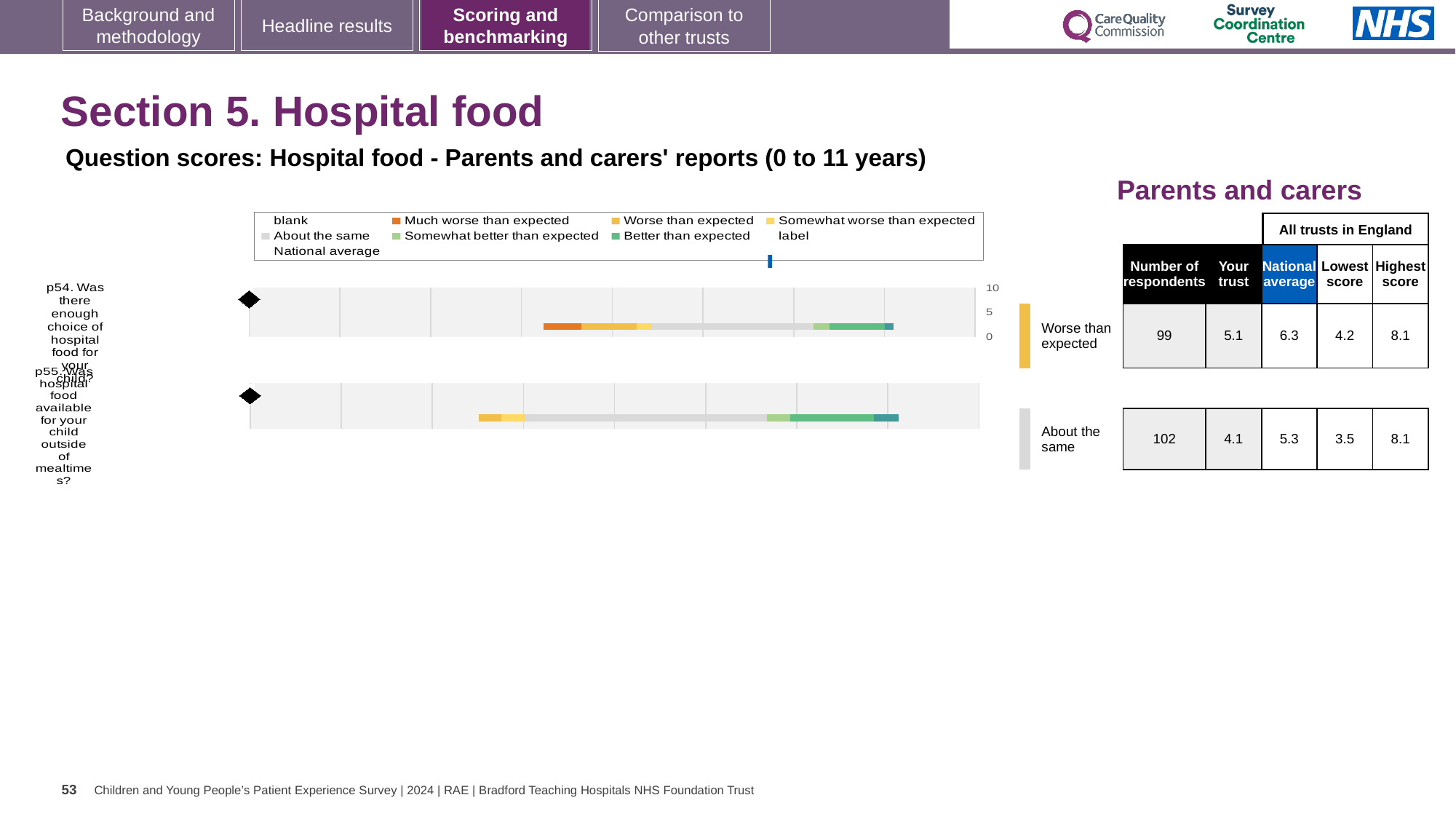
In the table on the right, what is the lowest score for the 'Worse than expected' row? 4.2 What kind of chart is shown on the slide? bar chart In the chart legend, what colour represents 'Better than expected'? green In the table on the right, what is the 'Your trust' score for the 'About the same' row? 4.1 In the table on the right, what is the number of respondents for the 'Worse than expected' row? 99 In the table on the right, what is the national average for the 'Worse than expected' row? 6.3 In the chart legend, what colour represents 'Much worse than expected'? orange How many survey questions (categories) are plotted in the chart? 2 In the table on the right, what is the difference between the national average and the 'Your trust' score for the 'Worse than expected' row? 1.2 In the table on the right, what is the highest score for the 'About the same' row? 8.1 In the table on the right, what is the difference in number of respondents between the 'About the same' row and the 'Worse than expected' row? 3 In the table on the right, for the 'Worse than expected' row, which is larger: the 'Your trust' score or the national average? National average